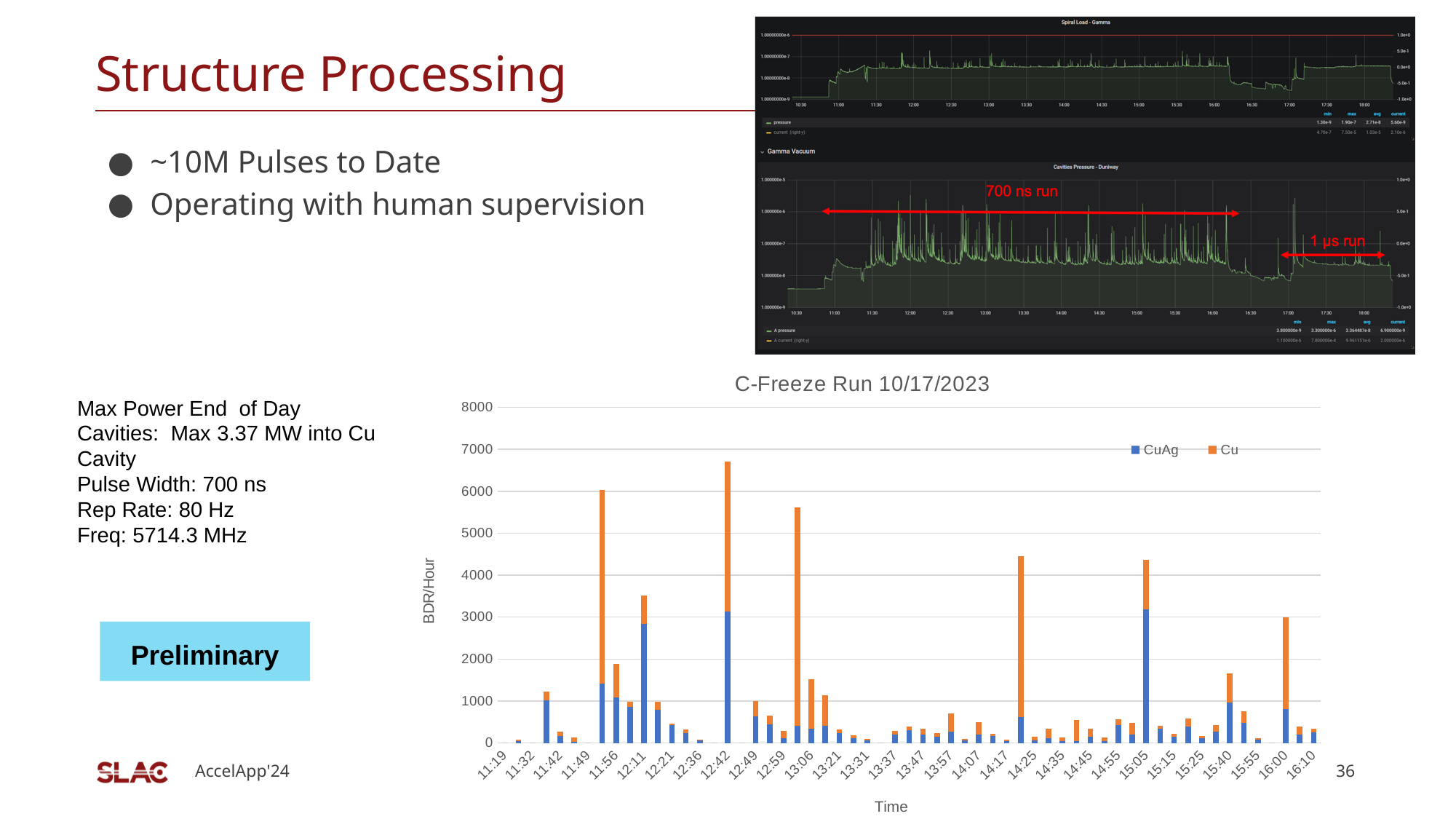
In the C-Freeze Run 10/17/2023 chart, is the total of the second tallest stacked bar greater or less than 5000? greater In the C-Freeze Run 10/17/2023 chart, is the total of the tallest stacked bar greater or less than 6000? greater What kind of chart is the C-Freeze Run 10/17/2023 chart? Stacked bar chart What kind of charts are shown in the dark screenshots at the top right of the slide? Line charts In the C-Freeze Run 10/17/2023 chart, which series forms the bottom segment of each stacked bar? CuAg What is the y-axis label of the C-Freeze Run 10/17/2023 chart? BDR/Hour What is the highest tick value shown on the y axis of the C-Freeze Run 10/17/2023 chart? 8000 How many series does the legend of the C-Freeze Run 10/17/2023 chart list? 2 In the C-Freeze Run 10/17/2023 chart, which colour represents the Cu series? Orange In the C-Freeze Run 10/17/2023 chart, is the total of the tallest stacked bar greater or less than 7000? less What is the x-axis label of the C-Freeze Run 10/17/2023 chart? Time What are the two series named in the legend of the C-Freeze Run 10/17/2023 chart? CuAg and Cu